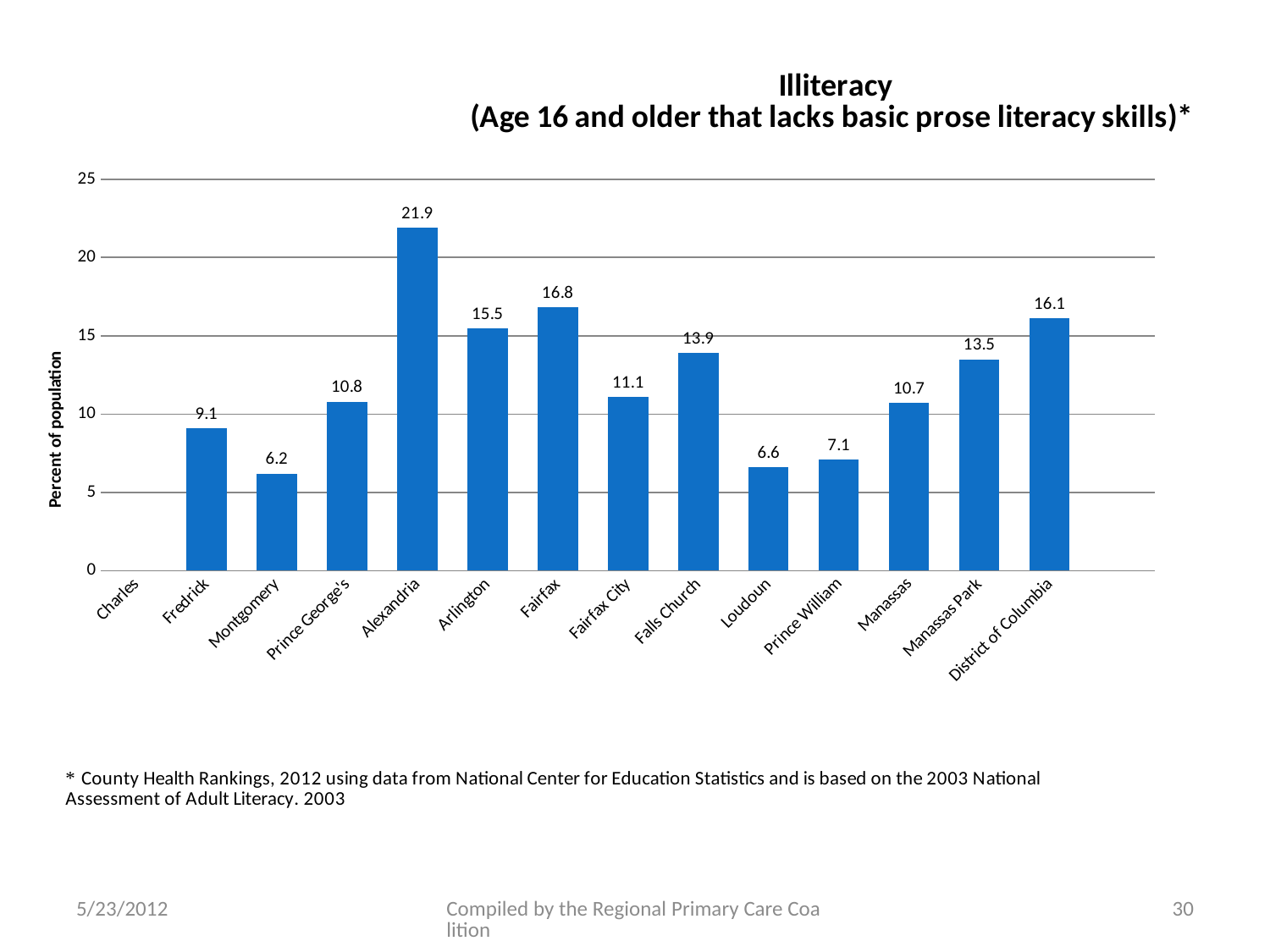
How many jurisdictions are labelled on the x axis? 14 What is the difference between the values for Fairfax and Fairfax City? 5.7 What is the value shown for Falls Church? 13.9 What is the value shown for Manassas Park? 13.5 What is the difference between the values for Alexandria and Fairfax? 5.1 Is the value for Alexandria greater or less than 20? greater Which jurisdiction has the highest illiteracy value? Alexandria Among the bars shown, which jurisdiction has the lowest value? Montgomery What is the illiteracy value for Alexandria? 21.9 What is the title of the vertical axis? Percent of population Which has a higher value, Arlington or Falls Church? Arlington What kind of chart is shown on the slide? bar chart